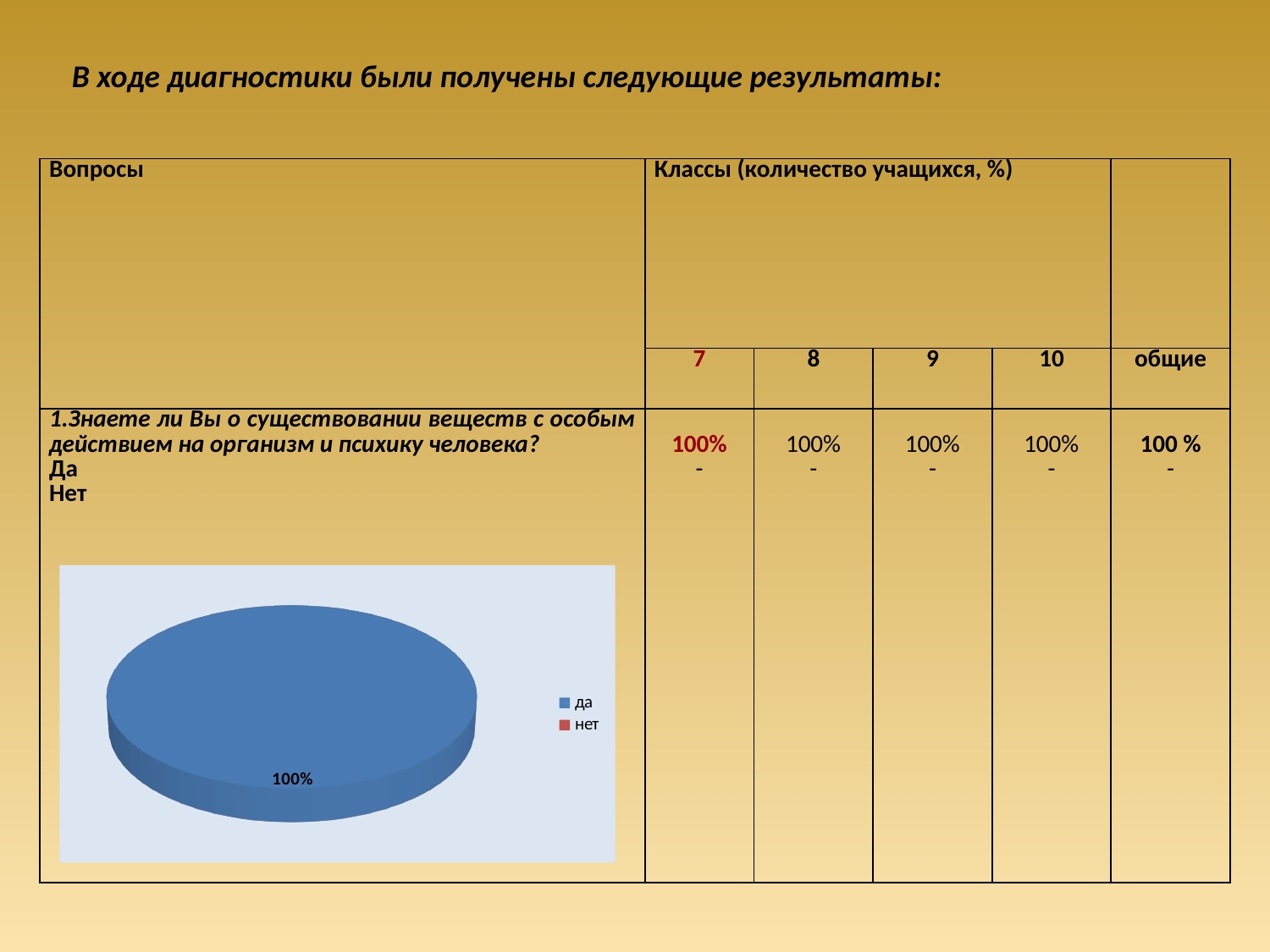
How many entries does the chart legend list? 2 What are the two legend entries of the pie chart? да, нет Is the share of the "да" slice greater or less than 50%? greater What data label is printed on the pie chart? 100% Which category fills the entire pie chart? да What colour is the "да" slice in the pie chart? blue Which slice is larger in the pie chart, "да" or "нет"? да What share of the pie does the "да" slice represent? 100% Which category has the largest slice in the pie chart? да What kind of chart is shown on the slide? pie chart